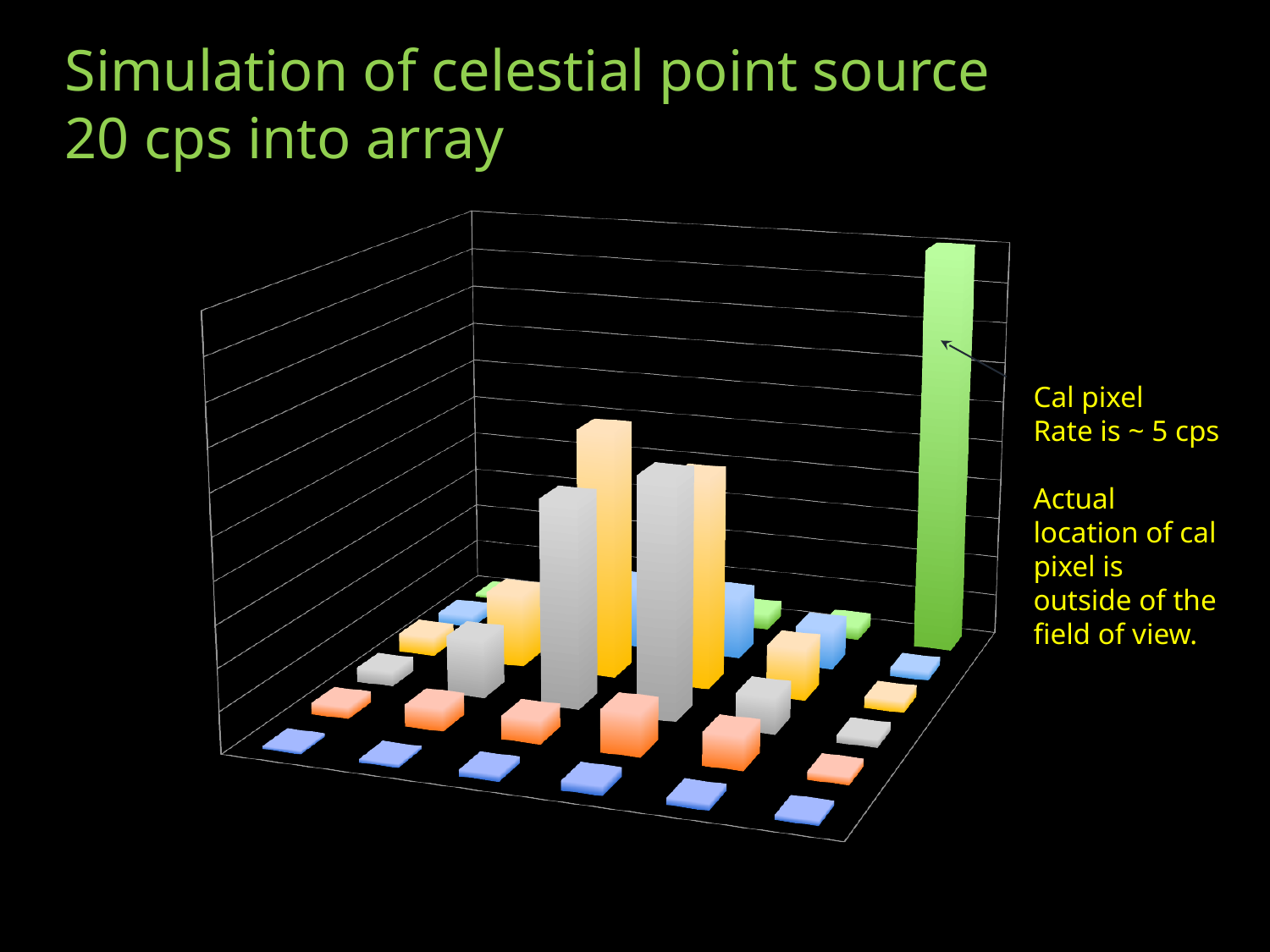
What is the title of the slide containing the chart? Simulation of celestial point source 20 cps into array Which pixel does the tallest bar in the chart represent, according to the annotation? Cal pixel What colour is the tallest bar in the chart? green What kind of chart is shown on the slide? bar chart